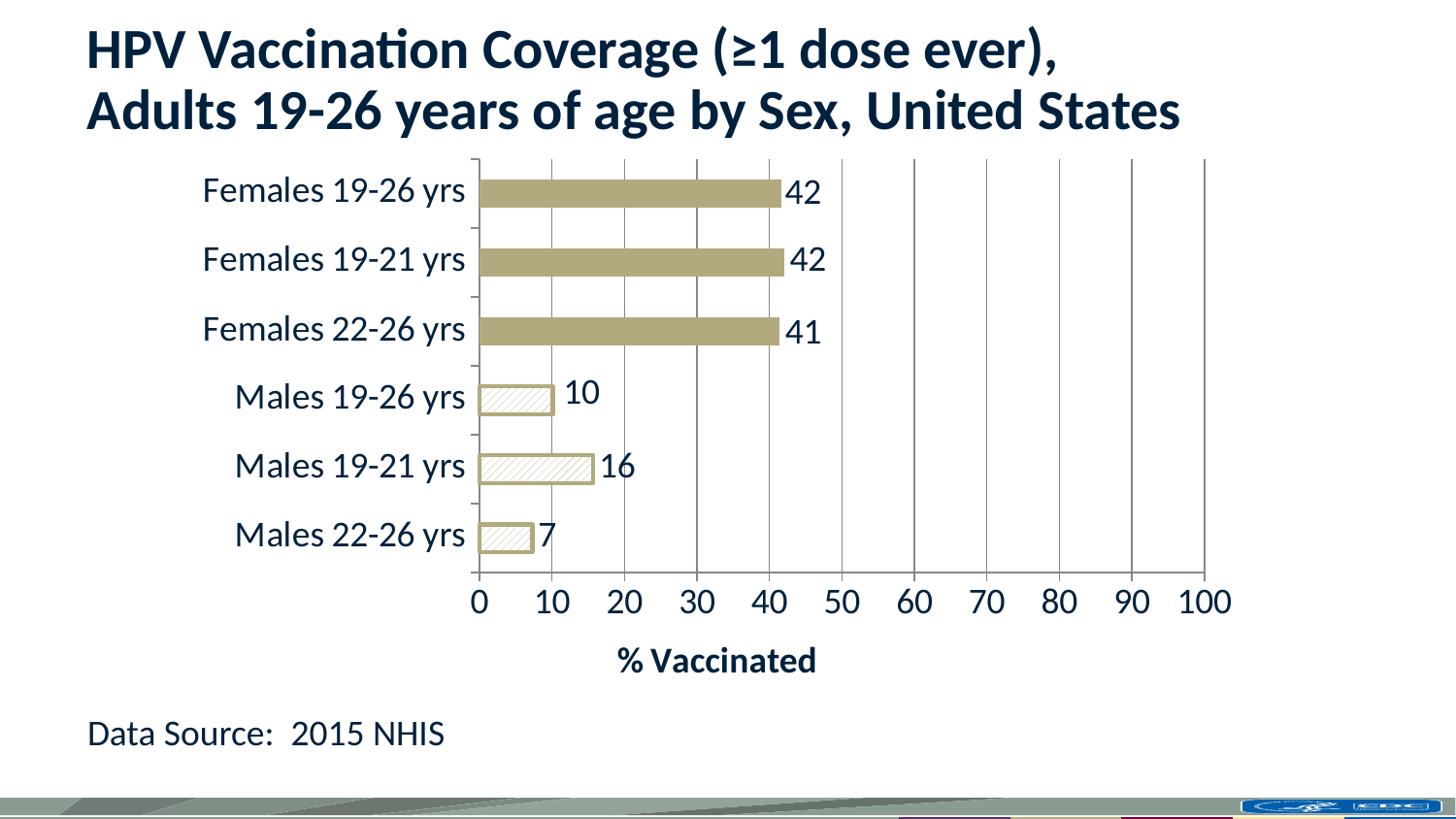
What is the value for Males 19-21 yrs? 16 What is the difference between the values for Females 19-26 yrs and Males 19-26 yrs? 32 What is the value for Males 22-26 yrs? 7 Which category has the lowest value? Males 22-26 yrs How many categories are shown on the chart? 6 What is the value for Females 19-26 yrs? 42 What is the difference between the values for Males 19-21 yrs and Males 22-26 yrs? 9 Is the value for Females 19-21 yrs greater or less than 30? greater What is the value for Females 22-26 yrs? 41 What is the label of the horizontal axis? % Vaccinated Which is larger, the value for Males 19-21 yrs or Males 19-26 yrs? Males 19-21 yrs What kind of chart is shown on the slide? bar chart